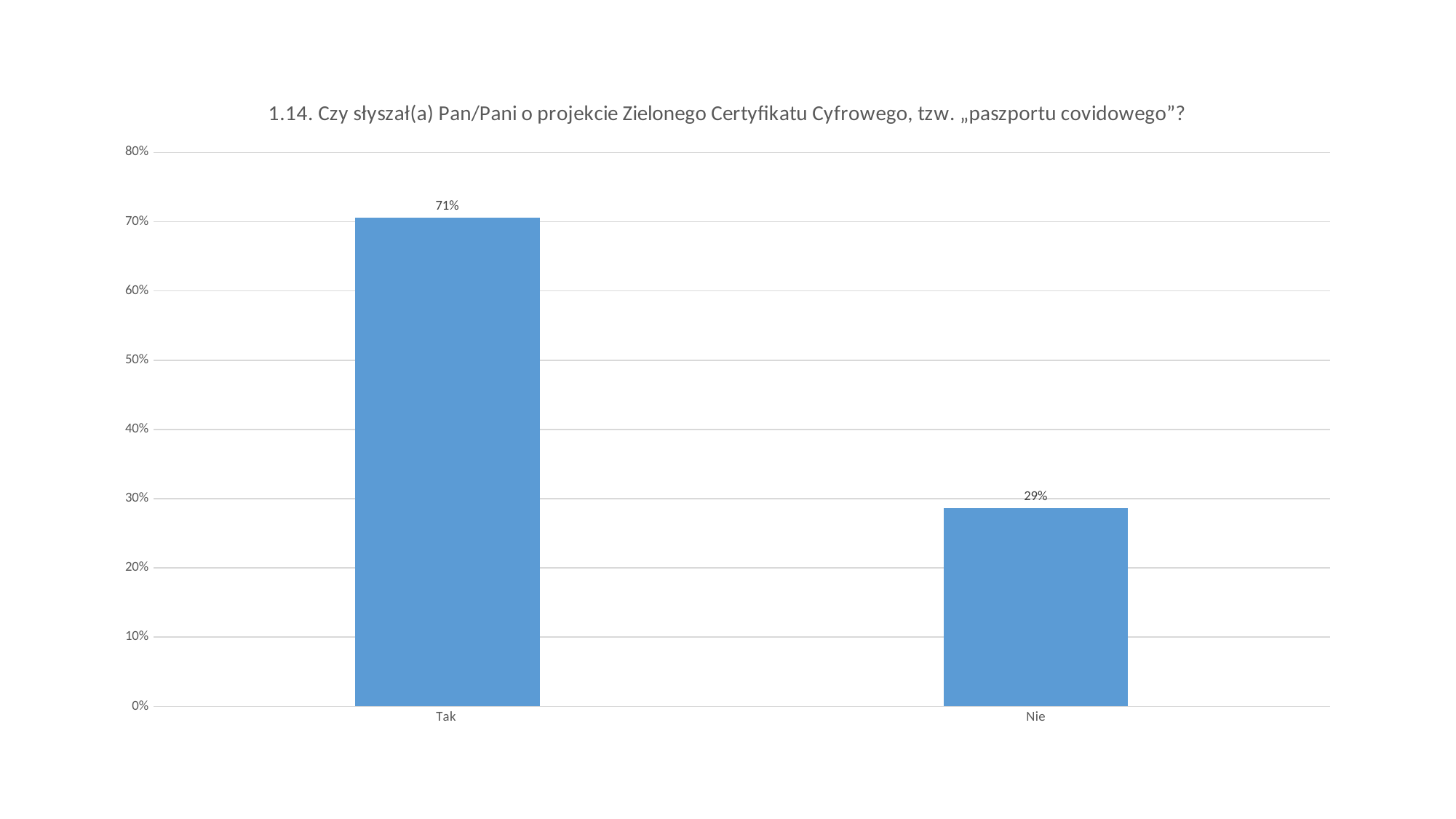
What kind of chart is shown on the slide? bar chart Which category has the highest value? Tak What is the difference between the values for Tak and Nie? 42% Which category has the lowest value? Nie Is the value for Nie greater or less than 30%? less How many categories are shown on the x axis? 2 What is the total of the values for Tak and Nie? 100% Which is larger, the value for Tak or the value for Nie? Tak Is the value for Tak greater or less than 60%? greater What is the value for Tak? 71% What is the value for Nie? 29% What is the highest value shown on the y axis? 80%